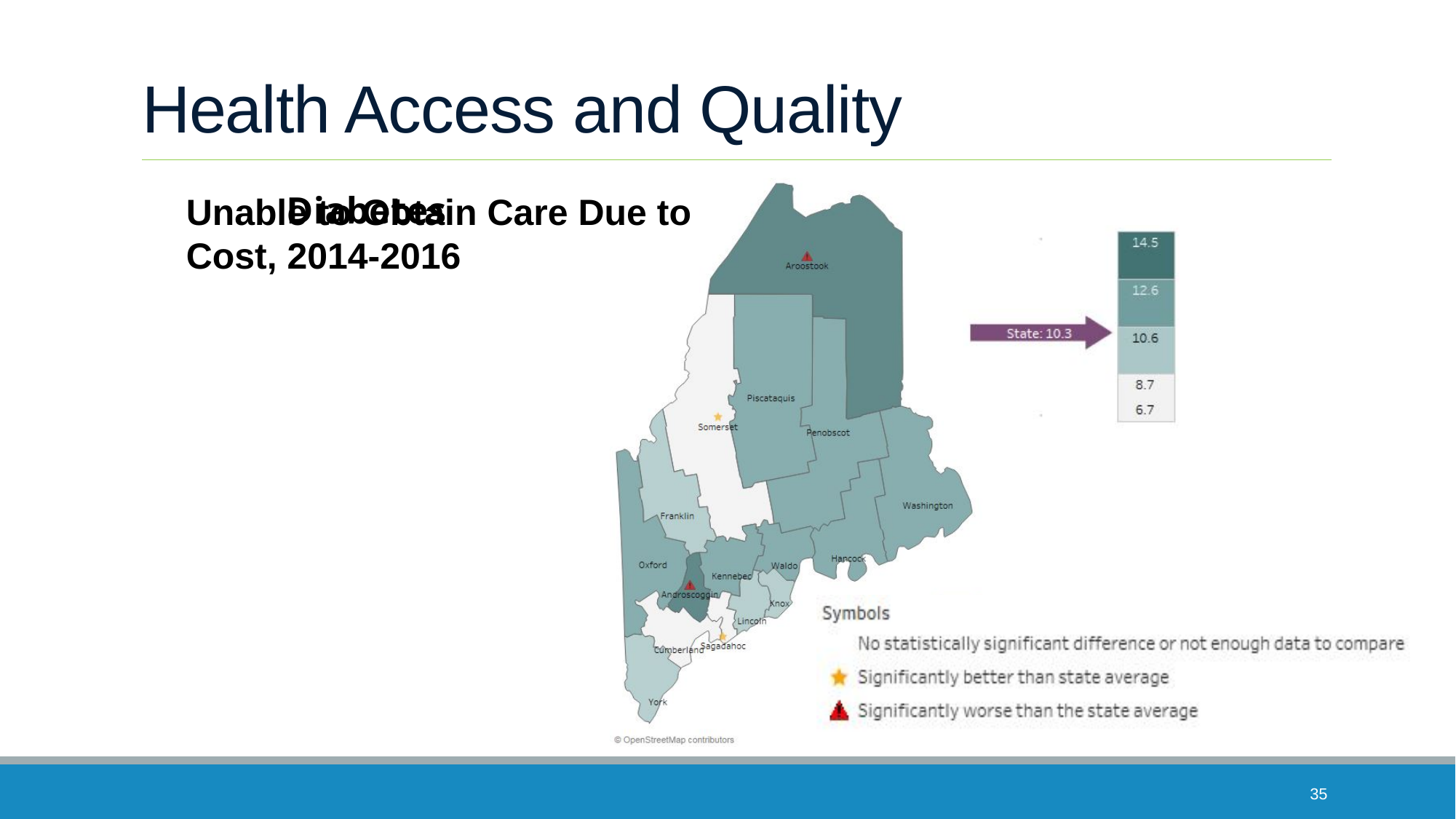
Which county has the higher value, Aroostook or Somerset? Aroostook Which counties are marked with a red triangle as significantly worse than the state average? Aroostook and Androscoggin How many values are listed on the map's colour legend? 5 How many counties are marked with a red triangle (significantly worse than the state average)? 2 What is the highest value shown on the map's colour legend? 14.5 Which counties are marked with a star as significantly better than the state average? Somerset and Sagadahoc What does the star symbol on the map indicate? Significantly better than state average What is the lowest value shown on the map's colour legend? 6.7 Is the value for Aroostook greater or less than the state value of 10.3? greater What kind of chart is shown on the slide? A map (choropleth map of Maine counties) What is the state value shown by the arrow next to the legend? State: 10.3 Is the value for Somerset greater or less than the state value of 10.3? less